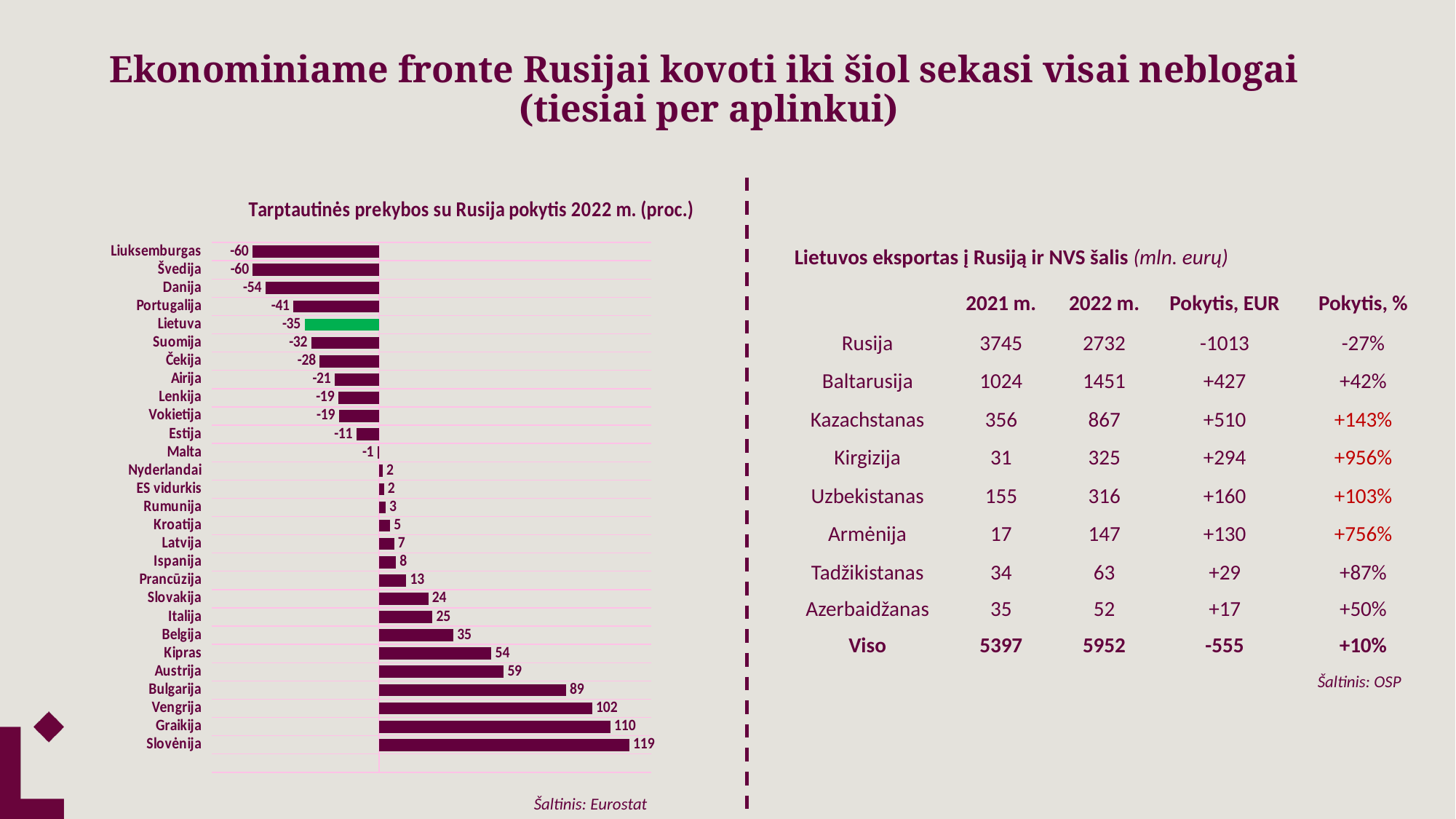
What is the value for Lietuva in the chart? -35 What is the difference between the values for Lietuva and Danija? 19 What kind of chart is shown on the slide? Bar chart What is the value for ES vidurkis in the chart? 2 What is the difference between the values for Graikija and Vengrija? 8 Which category's bar is highlighted in green in the chart? Lietuva How many countries/categories are shown in the chart? 28 What is the value for Vokietija in the chart? -19 Which has a larger value, Estija or Airija? Estija Which country has the highest value in the chart? Slovėnija Which has a larger value, Bulgarija or Kipras? Bulgarija What is the value for Slovėnija in the chart? 119